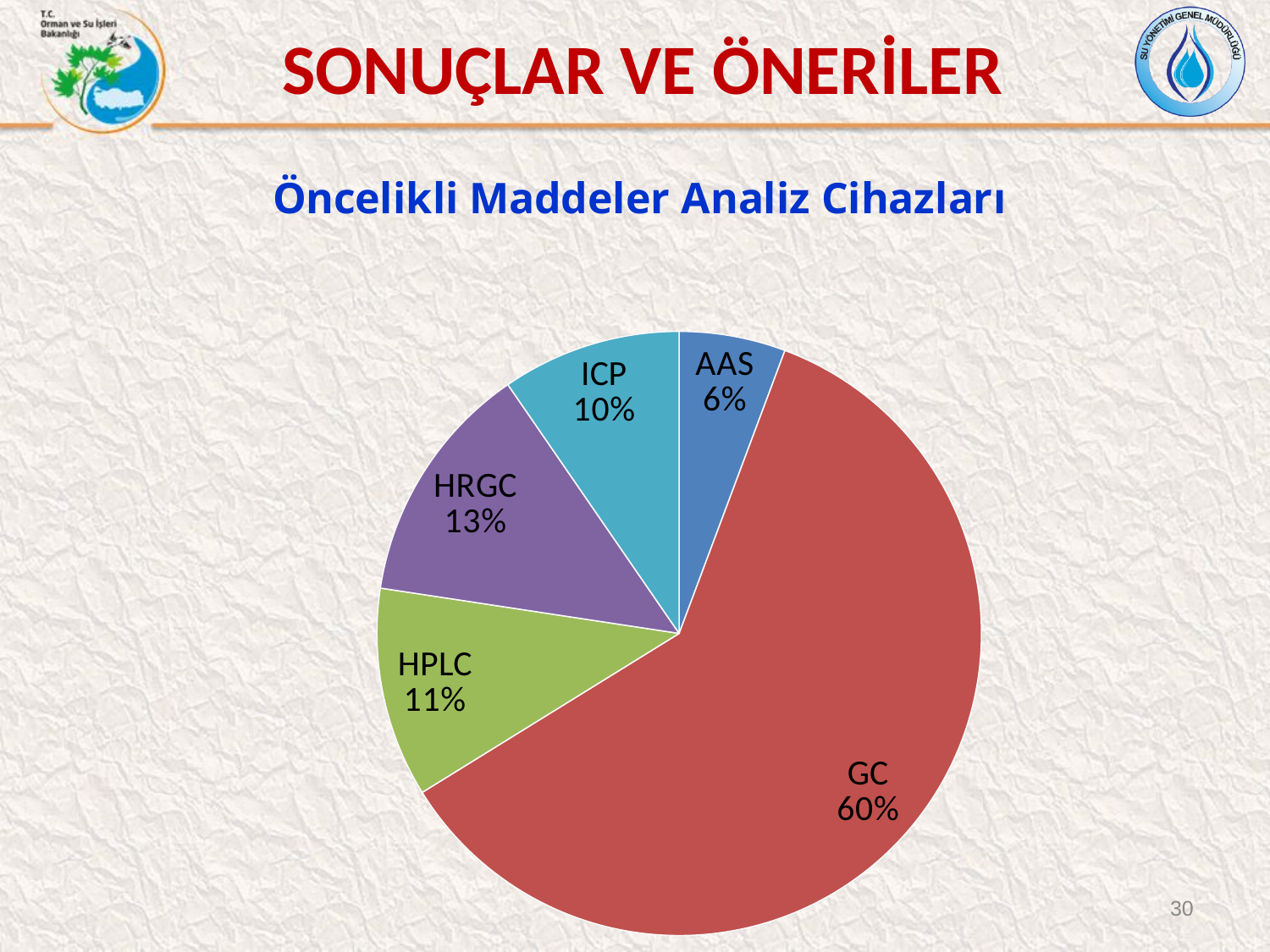
What is the value shown for ICP? 10% How many slices does the pie chart have? 5 What is the value shown for HPLC? 11% What share of the pie does AAS have? 6% What is the title of the chart? Öncelikli Maddeler Analiz Cihazları What share of the pie does GC have? 60% What is the difference between the shares of GC and HRGC? 47% Which is larger, the share for HRGC or the share for ICP? HRGC What share of the pie does HRGC have? 13% Which category has the largest slice of the pie? GC What kind of chart is shown on the slide? pie chart Which category has the smallest slice of the pie? AAS